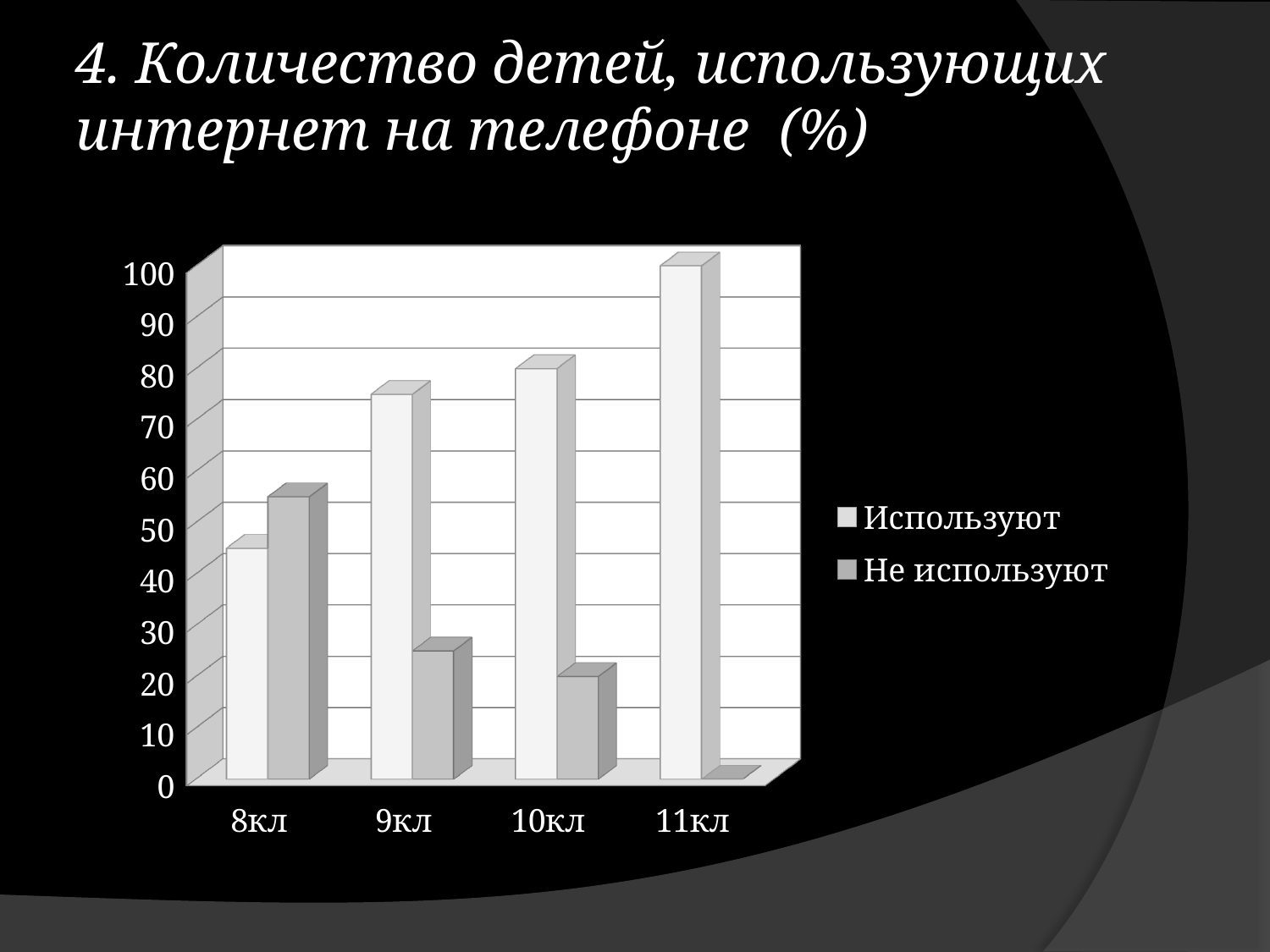
How many class categories are shown on the x axis? 4 Is the value for "Не используют" in 10кл greater or less than 30? less How many series does the legend list? 2 Is the value for "Используют" in 9кл greater or less than 70? greater Which class has the lowest value for "Не используют"? 11кл Which class has the lowest value for "Используют"? 8кл What kind of chart is shown on the slide? bar chart Does the value for "Используют" rise or fall from 8кл to 11кл? rise Which class has the highest value for "Не используют"? 8кл In 8кл, which is larger: "Используют" or "Не используют"? Не используют Which class has the highest value for "Используют"? 11кл Is the value for "Используют" in 8кл greater or less than 50? less